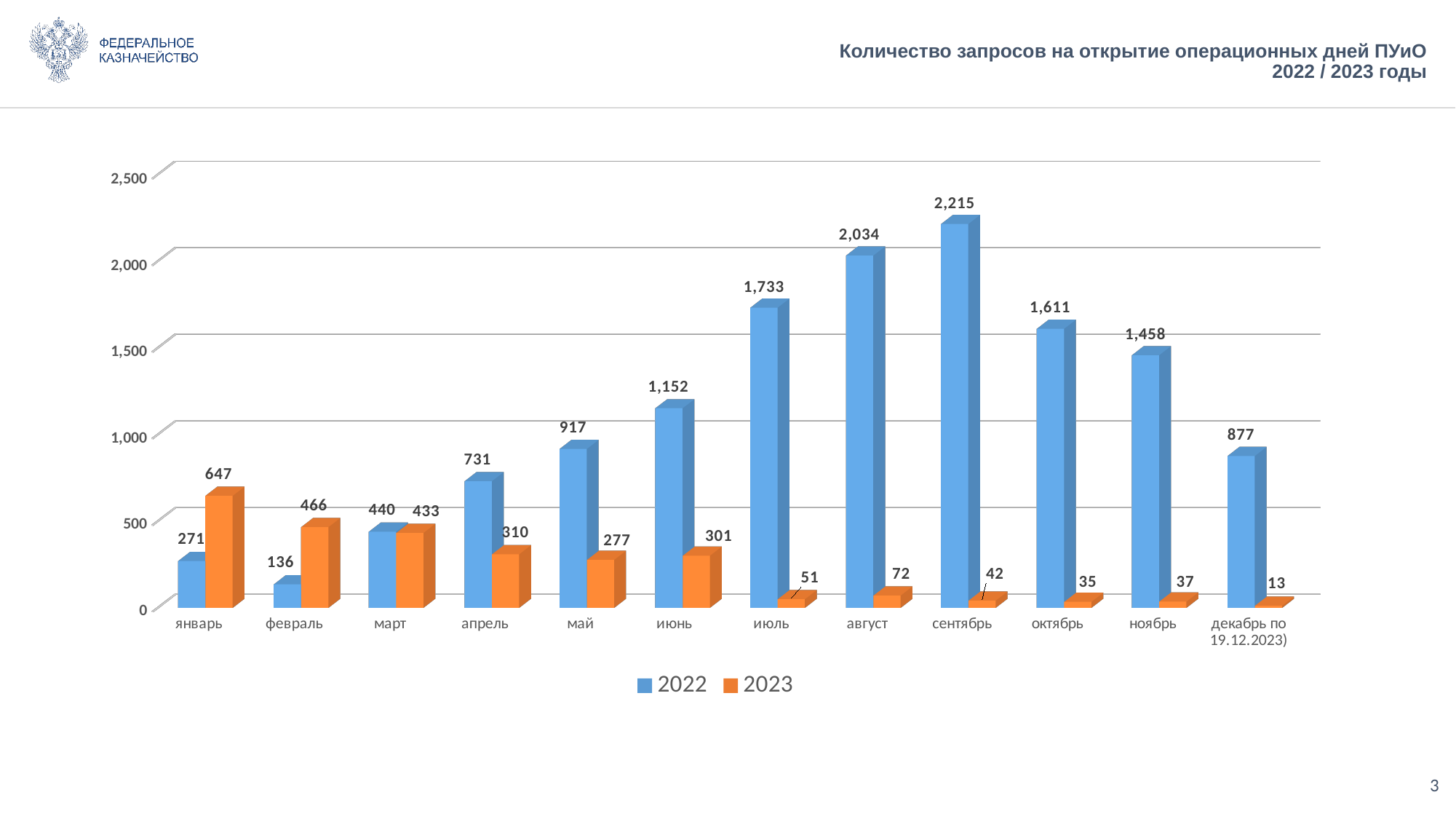
How many months are shown on the x axis? 12 What is the value for 2023 in декабрь по 19.12.2023)? 13 What is the value for 2022 in сентябрь? 2,215 What is the value for 2023 in январь? 647 What is the difference between the 2022 and 2023 values in июль? 1,682 How many series does the legend list? 2 In март, which series has the larger value, 2022 or 2023? 2022 Which month has the highest value for the 2022 series? сентябрь Is the value for 2022 in август greater or less than 2,000? greater Which colour represents the 2023 series in the legend? orange What kind of chart is shown on the slide? bar chart Which month has the lowest value for the 2023 series? декабрь по 19.12.2023)